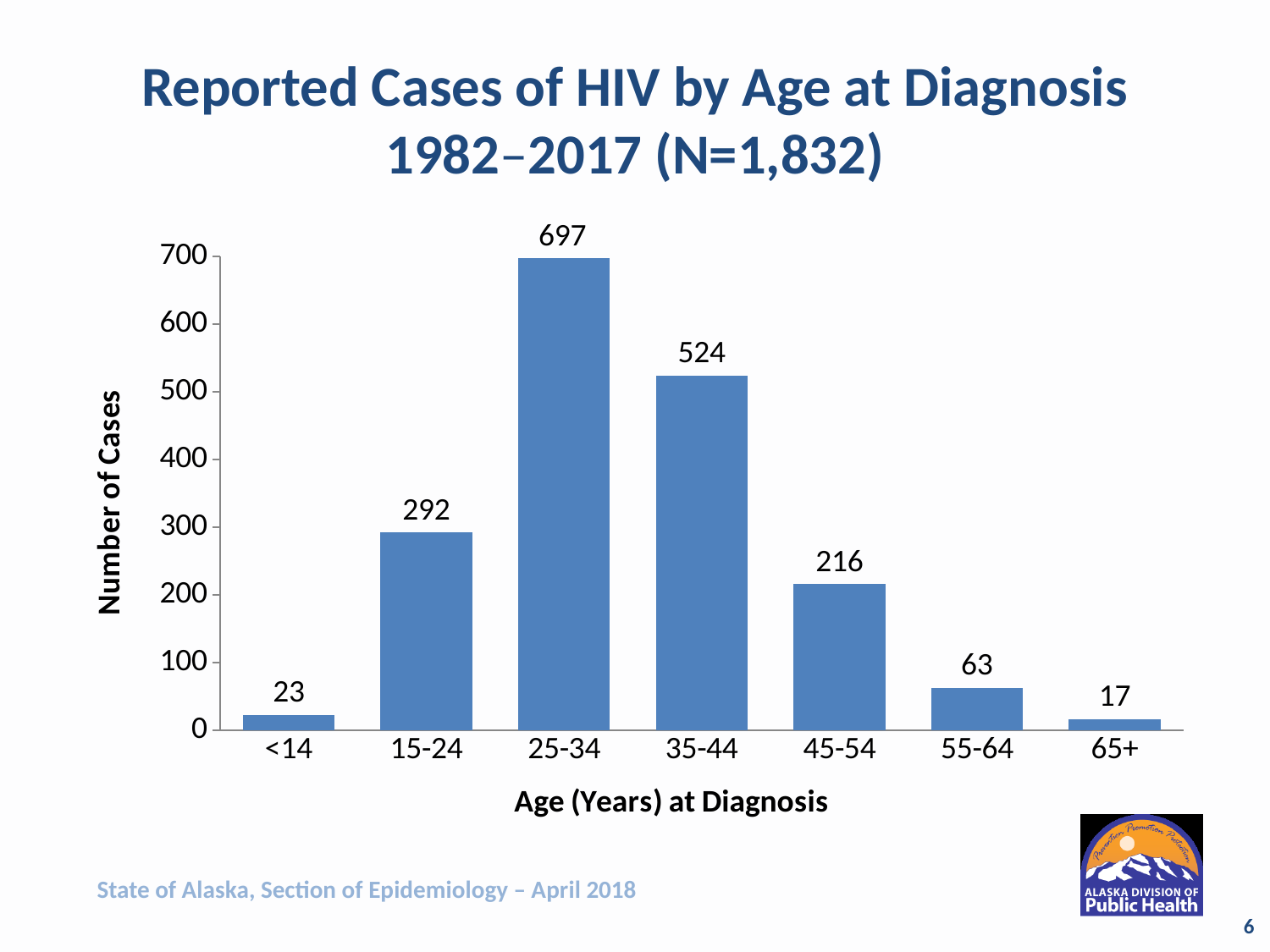
Is the value for the 35-44 age group greater or less than 500? greater How many reported HIV cases were diagnosed in the 25-34 age group? 697 What is the number of cases for the 55-64 age group? 63 What is the label of the y axis? Number of Cases How many cases are shown for the <14 age group? 23 Which age group has the lowest number of reported cases? 65+ Which age group has more cases, 15-24 or 45-54? 15-24 What is the difference in cases between the 15-24 and 45-54 age groups? 76 What kind of chart is shown on the slide? Bar chart How many age groups are shown on the x axis? 7 What is the difference in cases between the 25-34 and 35-44 age groups? 173 Which age group has the highest number of reported cases? 25-34